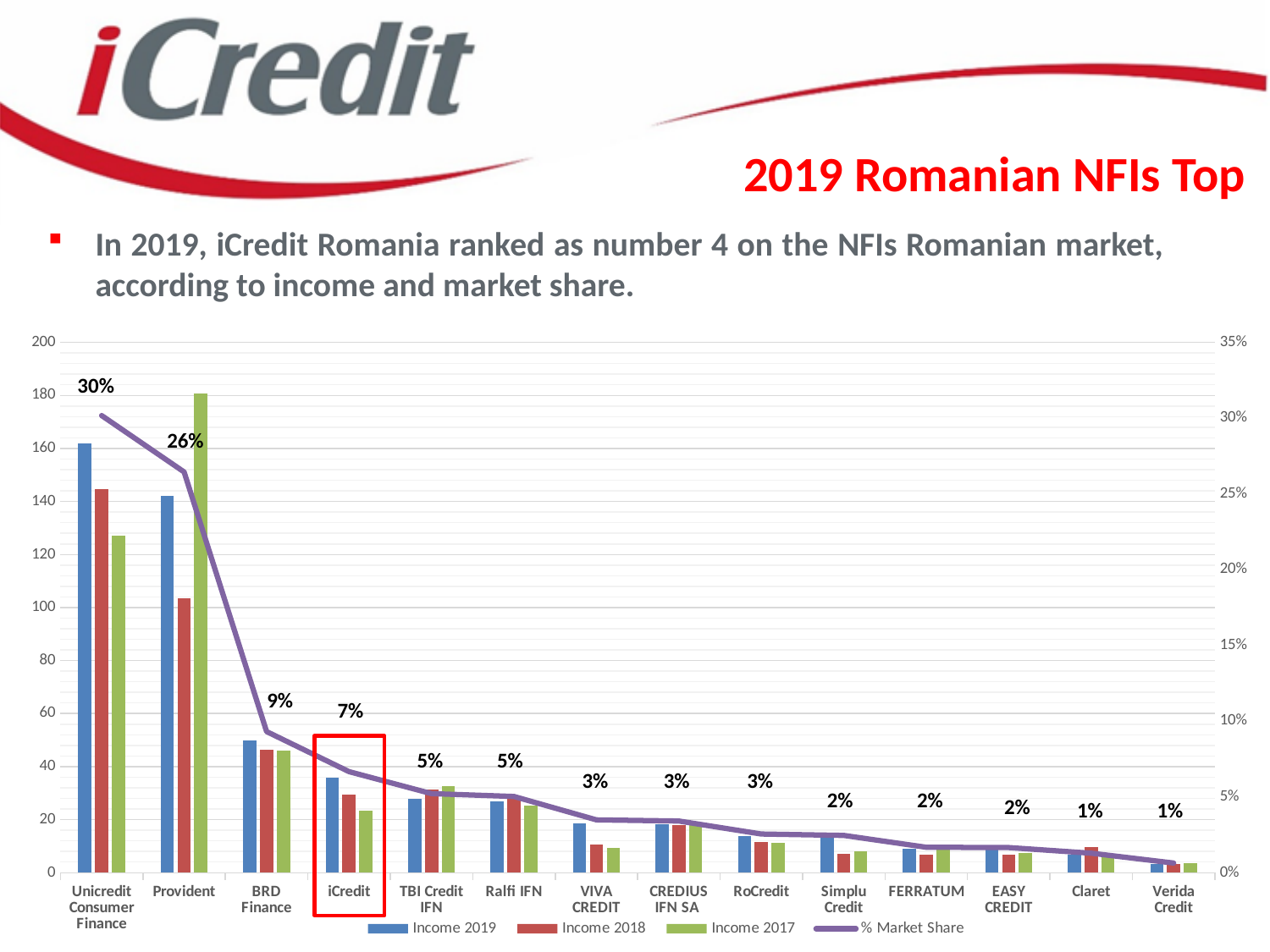
Does the % Market Share line rise or fall from left to right along the x axis? fall Which company has the highest % Market Share on the chart? Unicredit Consumer Finance Is the Income 2019 value for iCredit greater or less than 40? less Is the Income 2017 value for Provident greater or less than 160? greater How many companies are shown on the x axis of the chart? 14 Is the Income 2019 value for Unicredit Consumer Finance greater or less than 140? greater How many series does the chart legend list? 4 Which has a larger % Market Share, BRD Finance or iCredit? BRD Finance What is the difference in % Market Share between Unicredit Consumer Finance and Provident? 4% What is the % Market Share value shown for BRD Finance? 9% What is the % Market Share value shown for Unicredit Consumer Finance? 30% What is the % Market Share value shown for iCredit? 7%